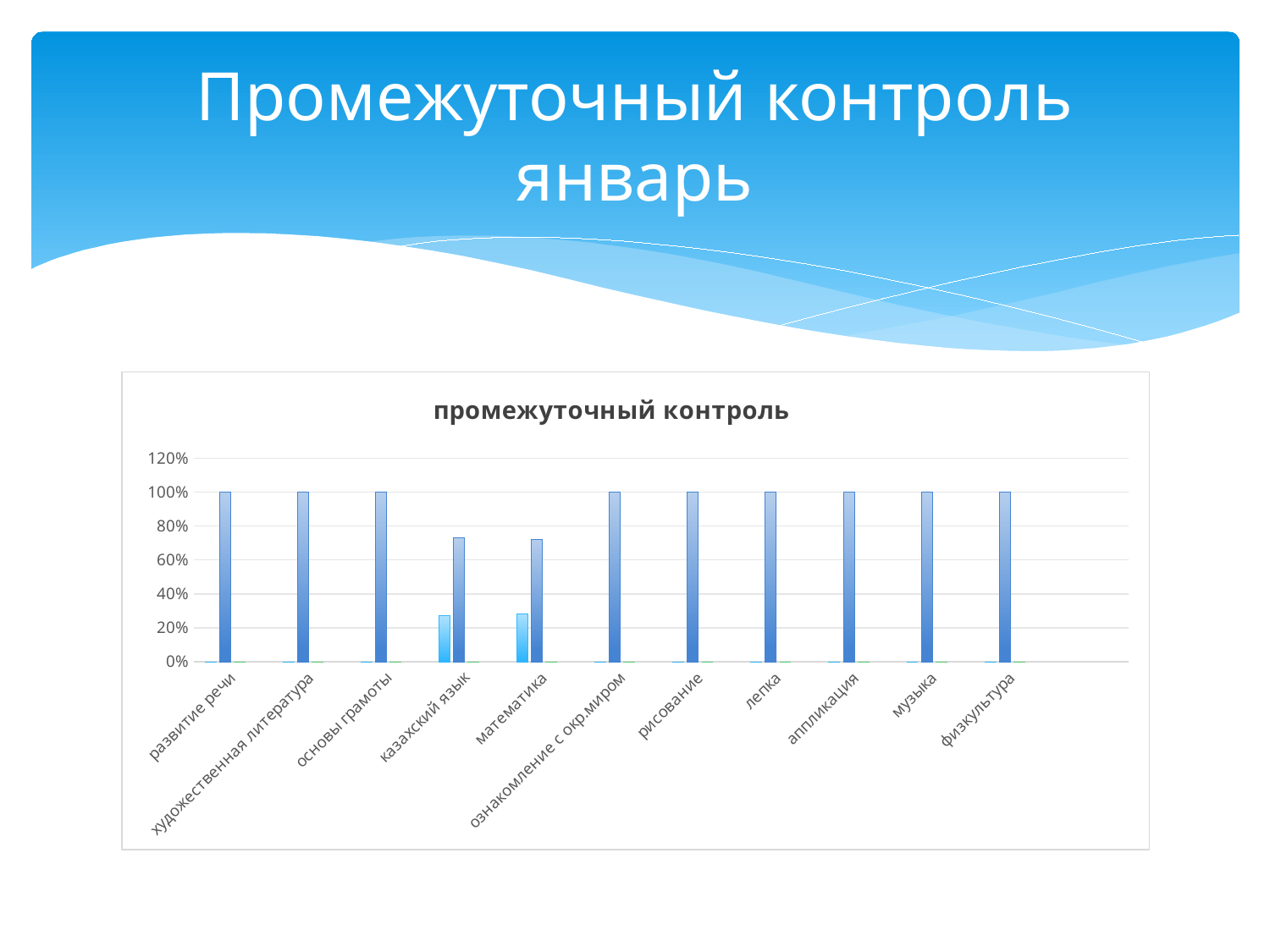
Which has the larger dark blue bar, основы грамоты or казахский язык? основы грамоты Is the value of the dark blue bar for математика greater or less than 80%? less What is the value of the dark blue bar for физкультура? 100% Is the value of the light blue bar for математика greater or less than 20%? greater What kind of chart is shown on the slide? bar chart How many categories are shown on the x axis of the chart? 11 Is the value of the dark blue bar for казахский язык greater or less than 60%? greater What is the value of the dark blue bar for рисование? 100% What is the title of the chart? промежуточный контроль What is the highest value shown on the vertical axis of the chart? 120% What is the value of the dark blue bar for развитие речи? 100%